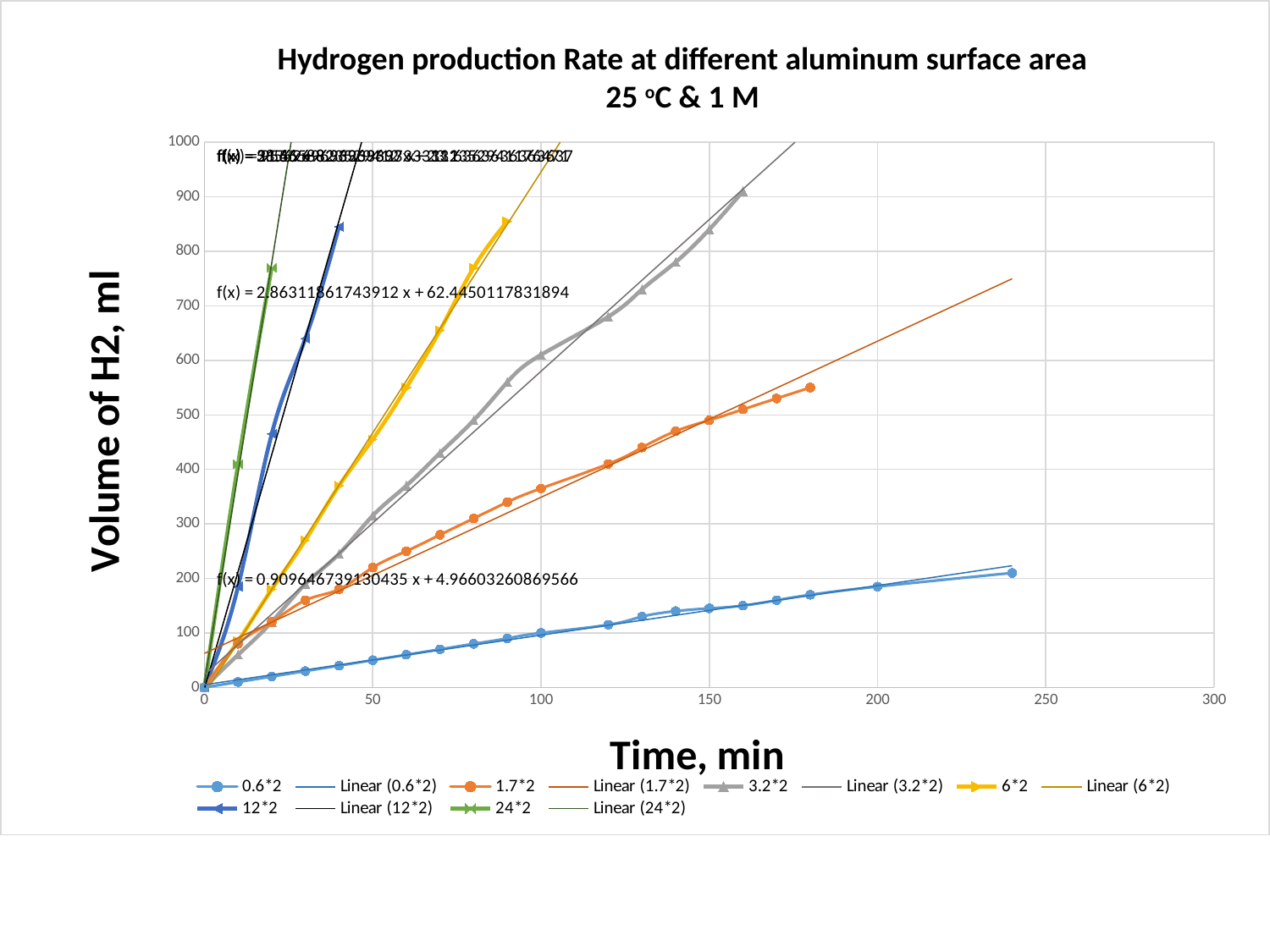
What kind of chart is shown on the slide? Line chart At 100 min, which series has the larger volume of H2: 3.2*2 or 1.7*2? 3.2*2 Which series has the lowest volume of H2 throughout the chart? 0.6*2 Is the value for the 0.6*2 series at 200 min greater or less than 200? less What is the title of the chart? Hydrogen production Rate at different aluminum surface area 25 oC & 1 M What is the label of the vertical axis? Volume of H2, ml How many entries does the legend list? 12 Does the volume of H2 for the 0.6*2 series rise or fall as time increases? Rise Is the value for the 1.7*2 series at 180 min greater or less than 500? greater At 40 min, which series has the larger volume of H2: 12*2 or 6*2? 12*2 How many data series (excluding the linear trendlines) are plotted? 6 Is the value for the 24*2 series at 20 min greater or less than 700? greater